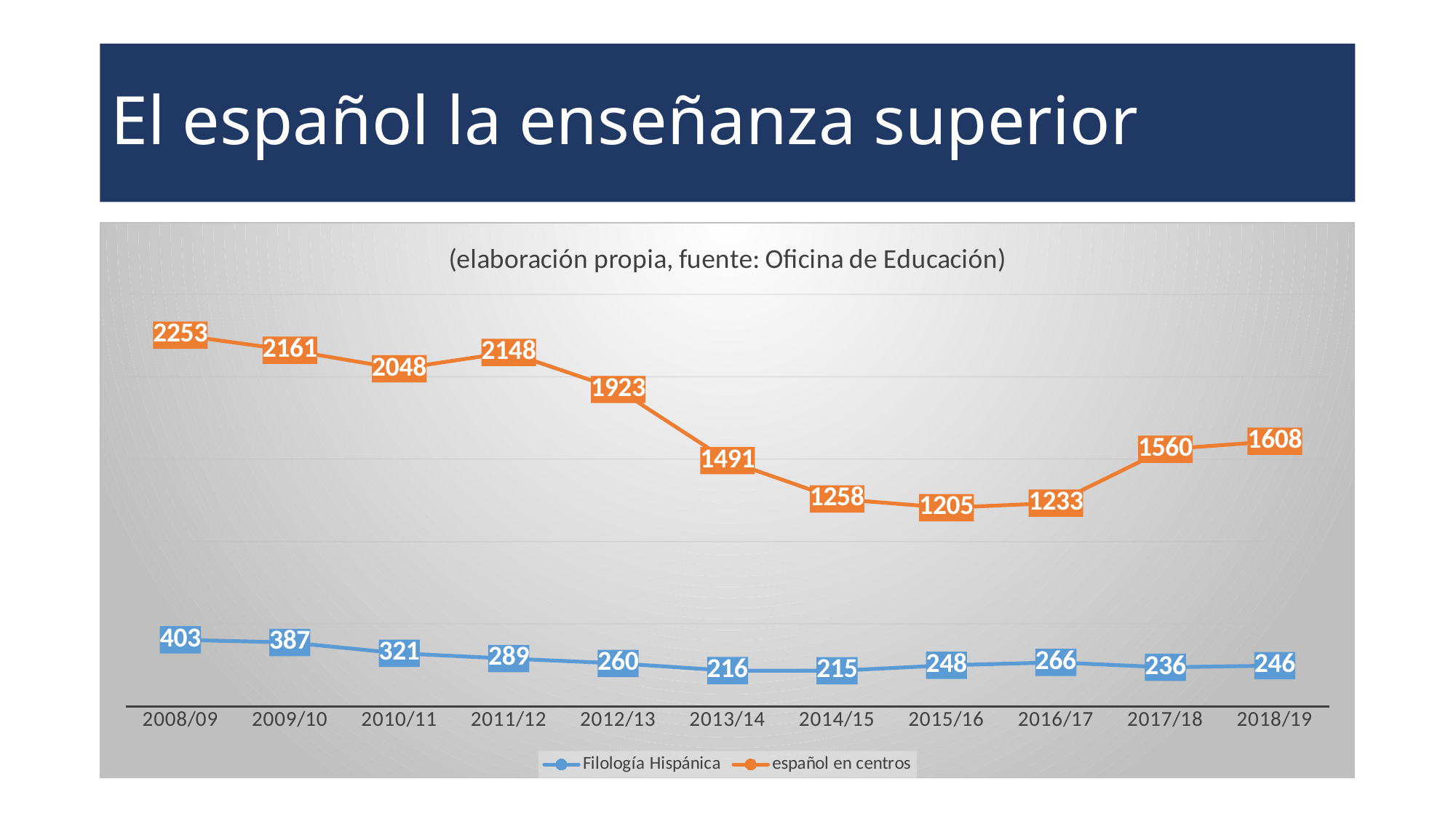
Does "español en centros" rise or fall from 2008/09 to 2015/16? Fall What kind of chart is shown on the slide? Line chart What is the value for "español en centros" in 2018/19? 1608 In which academic year is "Filología Hispánica" highest? 2008/09 What is the value for "Filología Hispánica" in 2014/15? 215 What is the value for "español en centros" in 2008/09? 2253 What is the difference between the "español en centros" values for 2008/09 and 2018/19? 645 How many series does the legend list? 2 In which academic year is "español en centros" lowest? 2015/16 What colour is the line for "Filología Hispánica"? Blue How many academic years are shown on the x axis? 11 Which is larger for "Filología Hispánica": the value in 2016/17 or the value in 2017/18? 2016/17